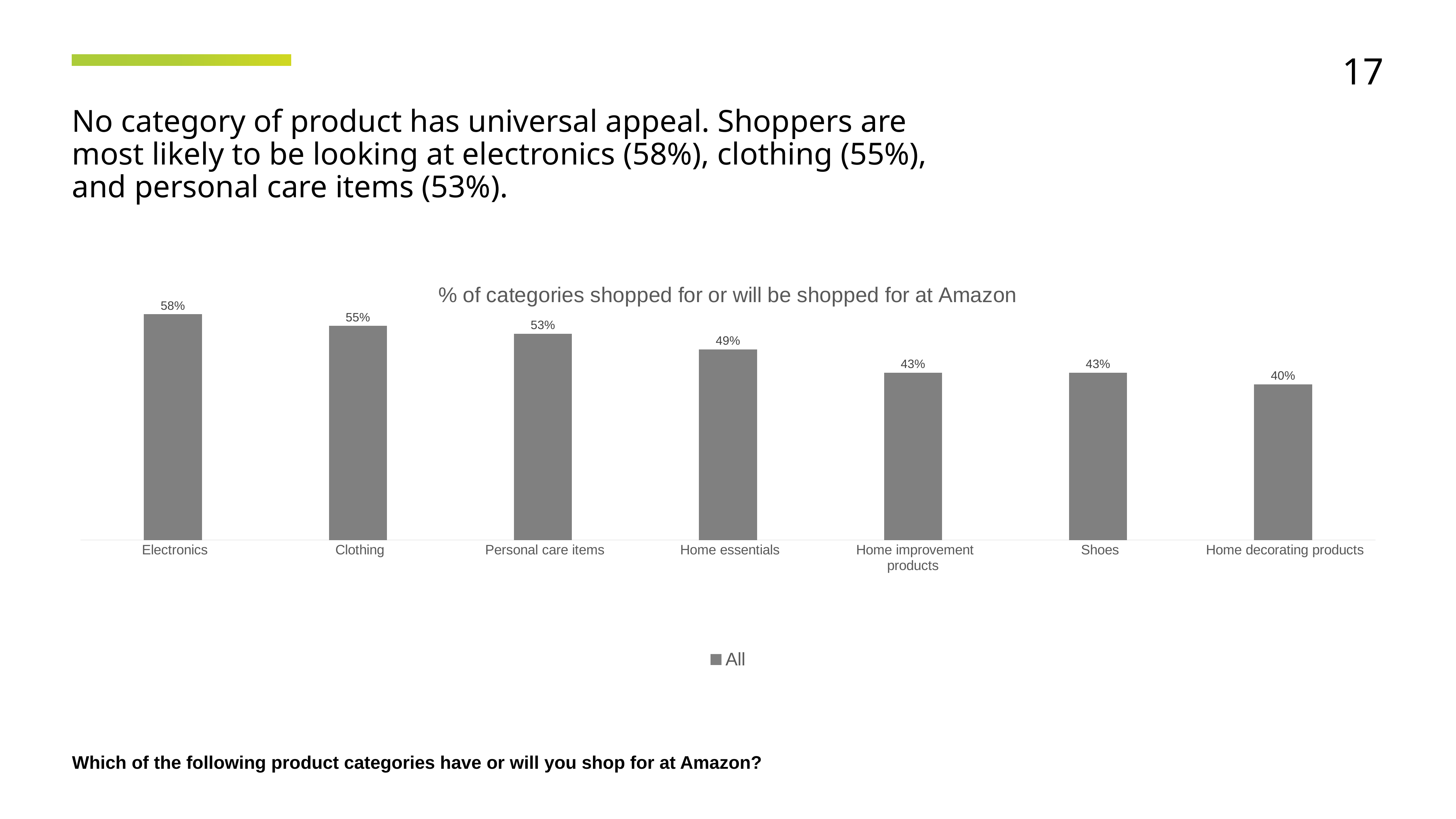
What kind of chart is shown on the slide? Bar chart What is the value for Home essentials? 49% Which category has the highest value? Electronics What is the title of the chart? % of categories shopped for or will be shopped for at Amazon Which is larger, the value for Clothing or the value for Home essentials? Clothing What is the value for Electronics? 58% What is the difference between the values for Personal care items and Shoes? 10% How many series does the legend list? 1 How many categories are shown on the chart? 7 What is the value for Home decorating products? 40% Which category has the lowest value? Home decorating products What is the difference between the values for Electronics and Clothing? 3%